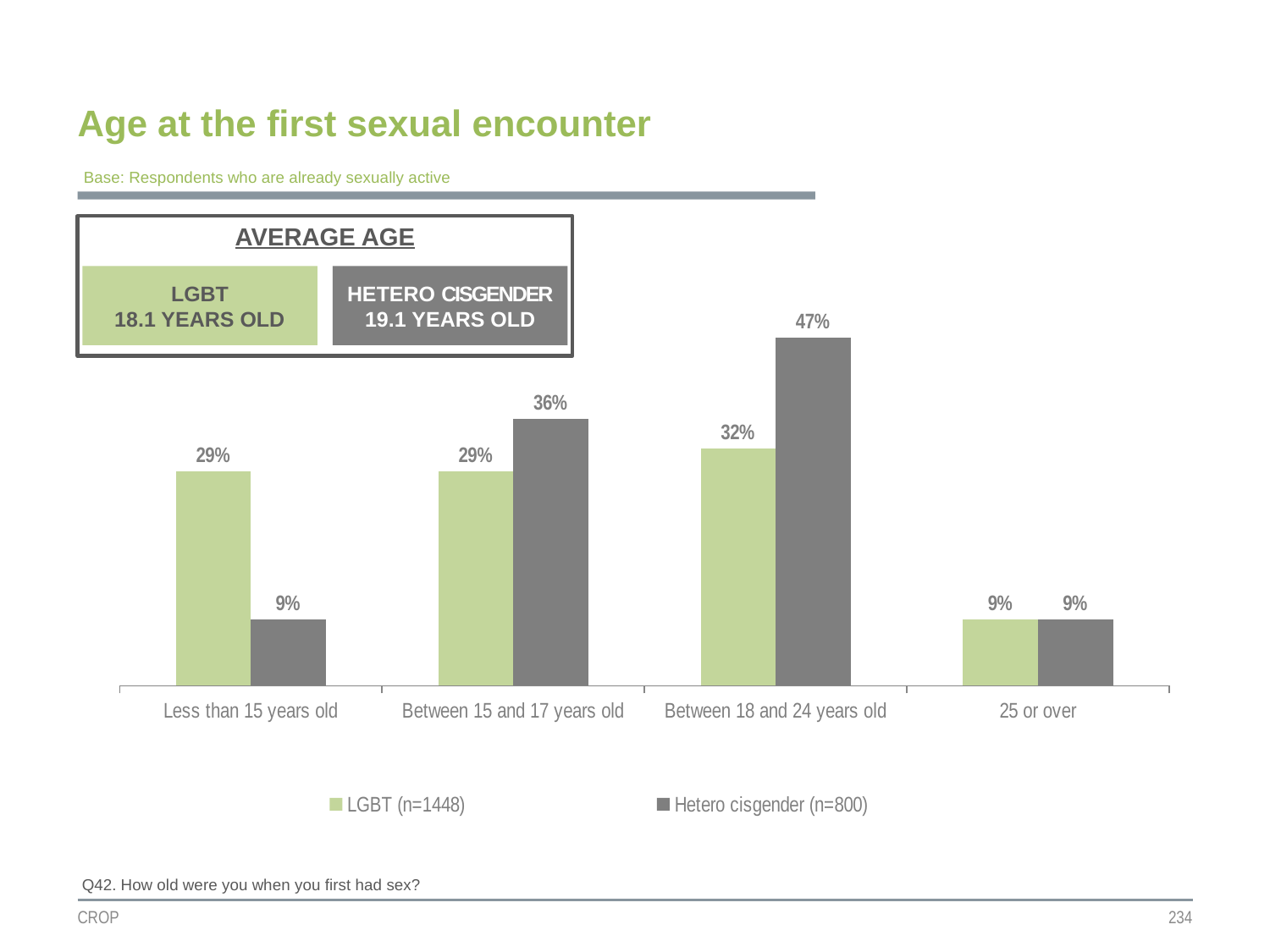
What kind of chart is shown on the slide? Bar chart How many series does the legend list? 2 What is the difference between the Hetero cisgender and LGBT values for 'Between 18 and 24 years old'? 15% How many age categories are shown on the x axis? 4 What is the difference between the LGBT and Hetero cisgender values for 'Less than 15 years old'? 20% What is the Hetero cisgender value for 'Between 18 and 24 years old'? 47% Which category has the highest Hetero cisgender value? Between 18 and 24 years old What is the sample size (n) for the LGBT series shown in the legend? 1448 Which category has the lowest LGBT value? 25 or over What is the Hetero cisgender value for 'Less than 15 years old'? 9% For 'Between 15 and 17 years old', which series has the larger value, LGBT or Hetero cisgender? Hetero cisgender What is the LGBT value for 'Less than 15 years old'? 29%